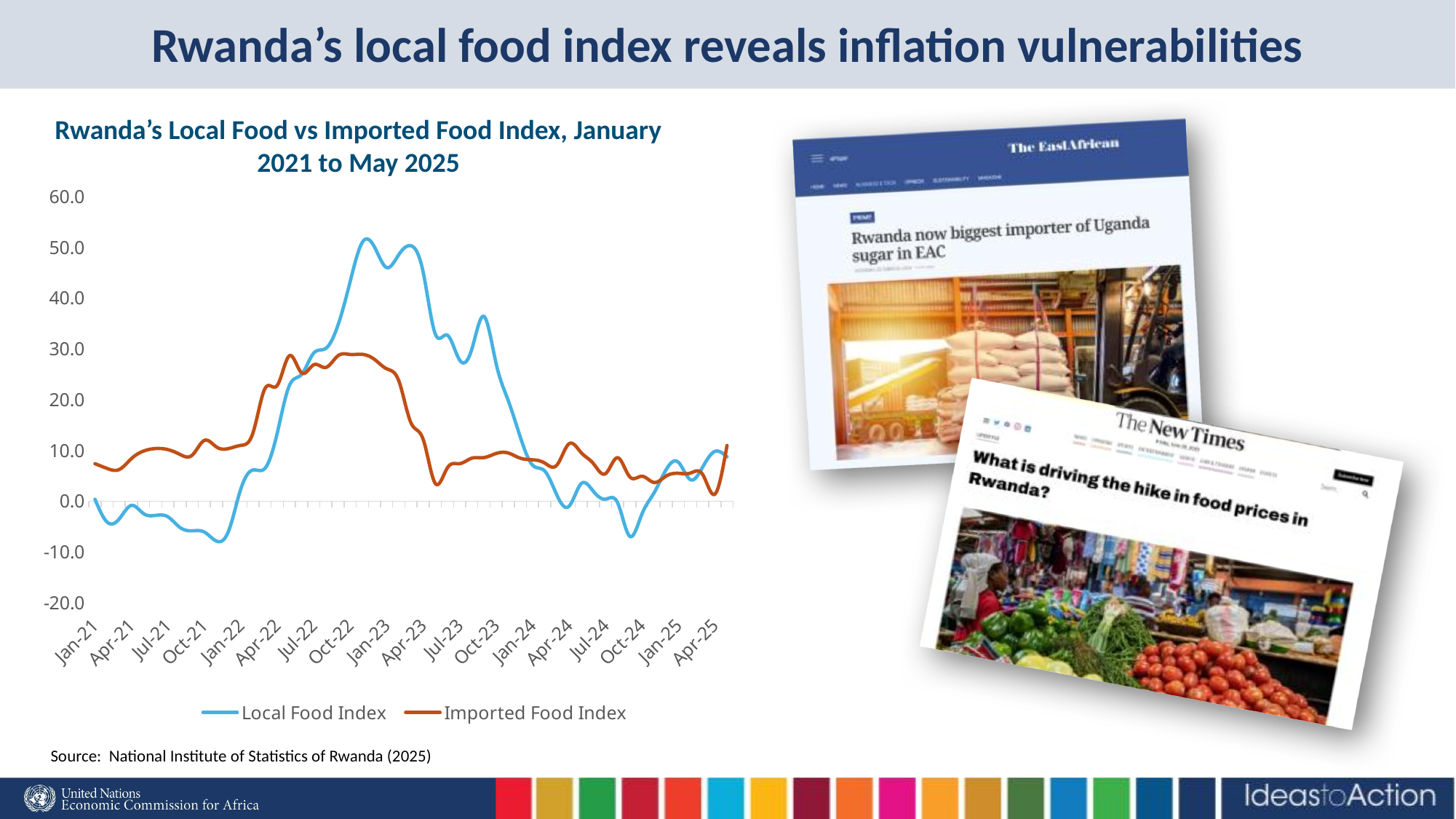
Is the Imported Food Index value at Jan-23 greater or less than 40? less How many series does the chart's legend list? 2 What kind of chart is shown on the slide? Line chart At Jan-22, which series is higher, the Local Food Index or the Imported Food Index? Imported Food Index At Jan-23, which series is higher, the Local Food Index or the Imported Food Index? Local Food Index Which series reaches the highest peak on the chart? Local Food Index What are the two series named in the chart's legend? Local Food Index and Imported Food Index How many date labels are shown on the x axis? 18 What is the source cited below the chart? National Institute of Statistics of Rwanda (2025) Is the Local Food Index value at Oct-24 greater or less than 0? less Is the Local Food Index value at Jan-23 greater or less than 40? greater Does the Local Food Index rise or fall between Jan-23 and Jan-24? fall